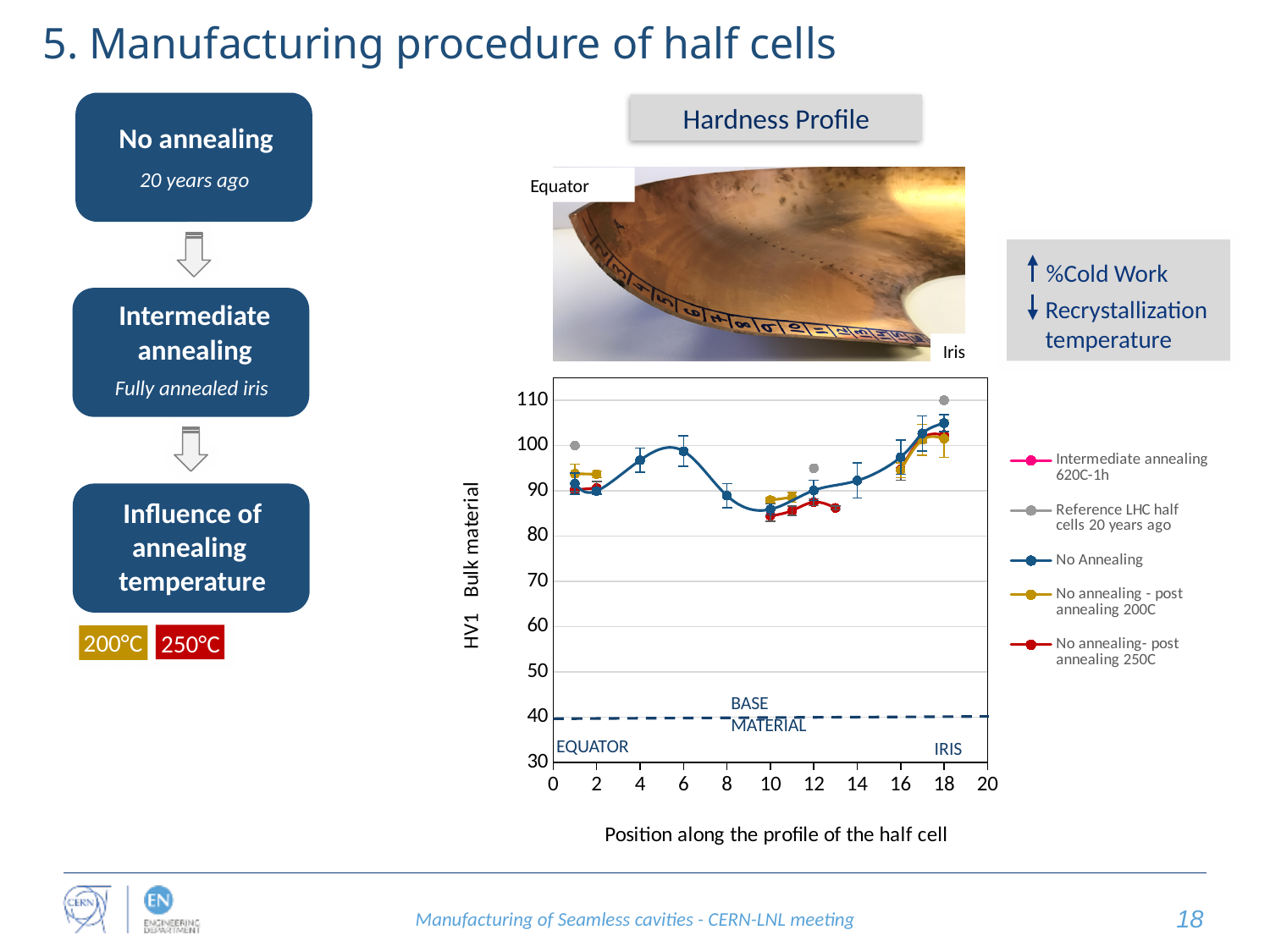
In the Hardness Profile chart, is the Reference LHC half cells 20 years ago value at position 12 greater or less than 90? greater What is the x-axis label of the Hardness Profile chart? Position along the profile of the half cell In the Hardness Profile chart, is the No Annealing value at position 18 greater or less than 100? greater What is the title of the chart on the slide? Hardness Profile In the Hardness Profile chart, at what HV1 value does the dashed BASE MATERIAL line sit? 40 In the Hardness Profile chart, which is larger for the No Annealing series: the value at position 18 or the value at position 10? position 18 How many series does the legend of the Hardness Profile chart list? 5 What kind of chart is the Hardness Profile chart? line chart In the Hardness Profile chart, does the No Annealing series rise or fall between position 8 and position 18? rise In the Hardness Profile chart, is the No Annealing value at position 4 greater or less than 90? greater In the Hardness Profile chart, which series is the highest at position 18? Reference LHC half cells 20 years ago